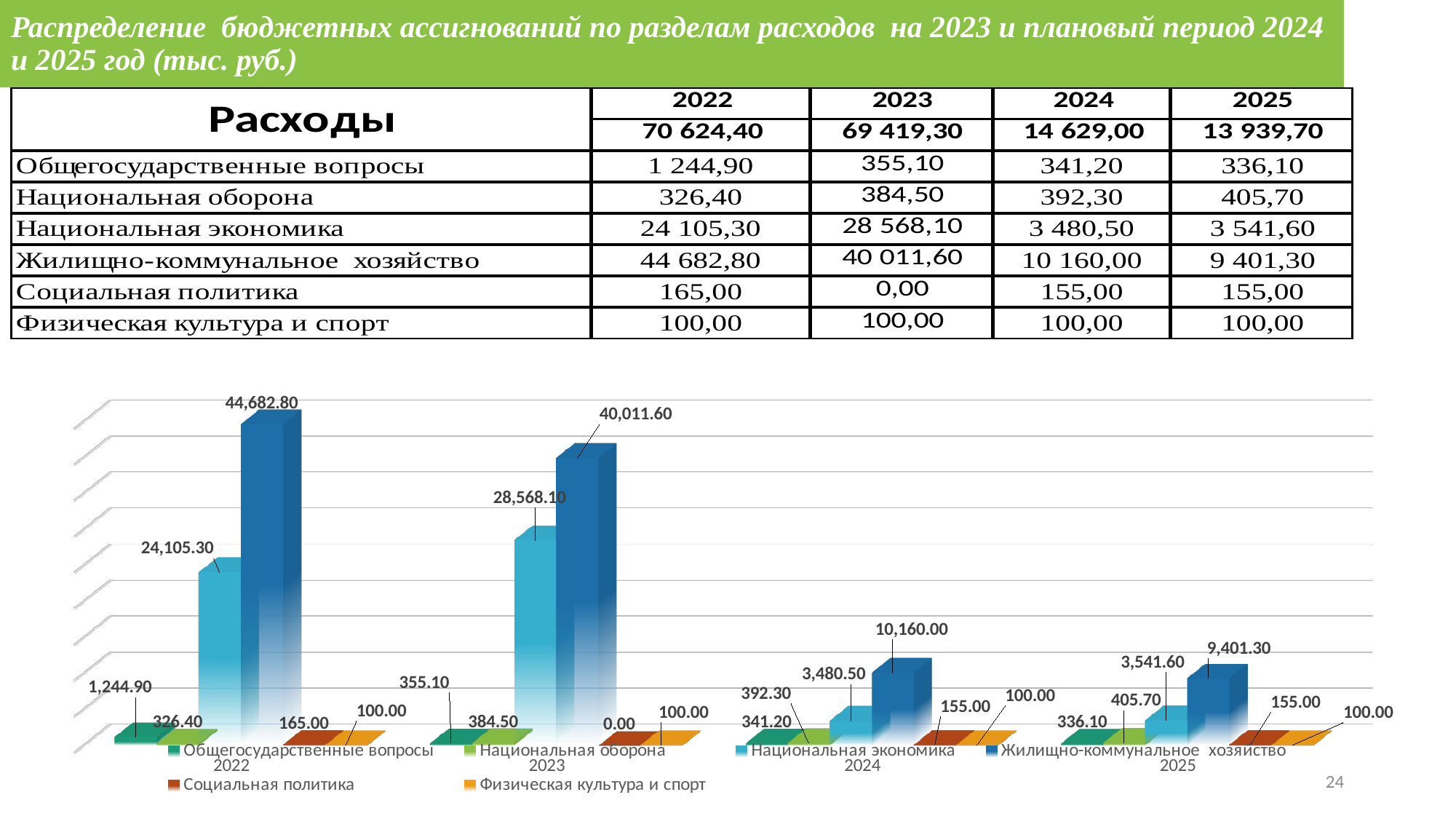
What is the value for Жилищно-коммунальное хозяйство in 2022 on the chart? 44,682.80 What kind of chart is shown on the slide? bar chart What is the value for Национальная экономика in 2023 on the chart? 28,568.10 How many year categories are shown along the x axis of the chart? 4 Which is larger on the chart: Национальная экономика in 2024 or Национальная экономика in 2025? Национальная экономика in 2025 Which year has the highest value for Жилищно-коммунальное хозяйство on the chart? 2022 What is the value for Национальная оборона in 2025 on the chart? 405.70 How many series does the chart legend list? 6 Does the value for Жилищно-коммунальное хозяйство rise or fall from 2022 to 2025 on the chart? fall What is the value for Социальная политика in 2023 on the chart? 0.00 What is the difference between the Жилищно-коммунальное хозяйство values for 2022 and 2023 on the chart? 4,671.20 Which year has the lowest value for Национальная экономика on the chart? 2024